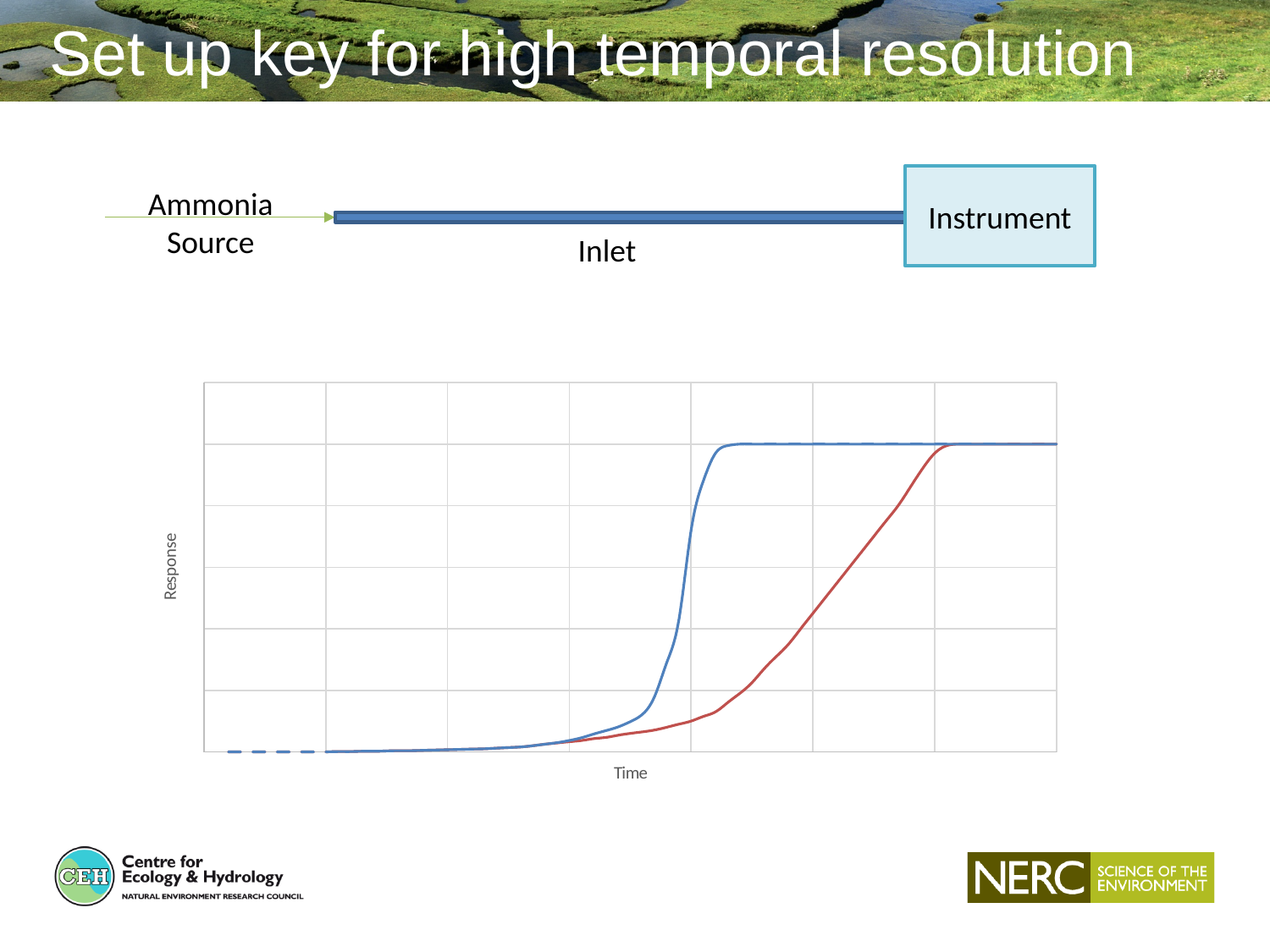
How many lines are plotted on the chart? 2 Which line rises more steeply, the blue line or the red line? blue line What is the label on the horizontal axis of the chart? Time Which line reaches its plateau earlier along the Time axis, the blue line or the red line? blue line Do the plotted values rise or fall along the Time axis? rise What is the label on the vertical axis of the chart? Response What kind of chart is shown on the slide? line chart